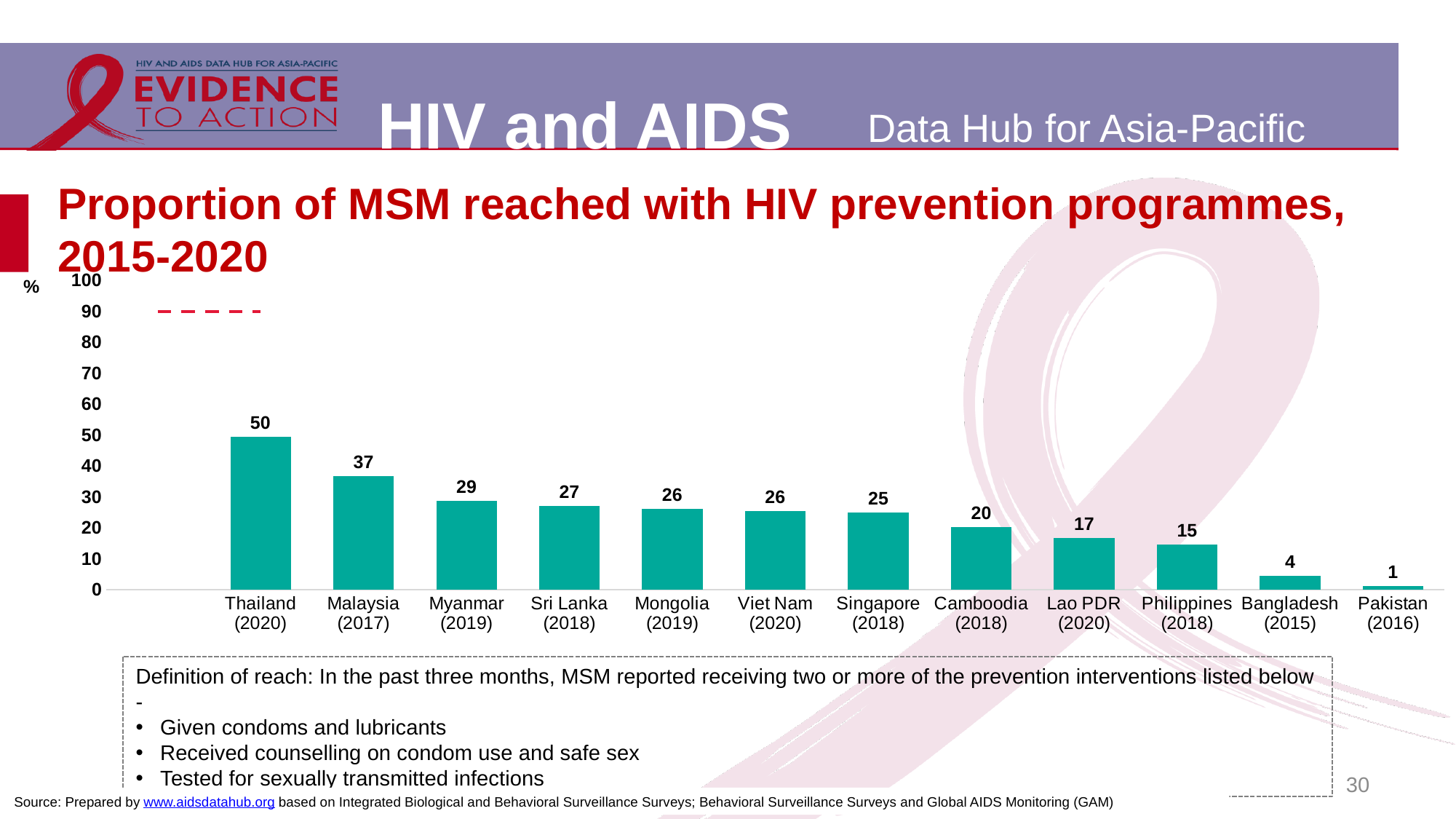
What is the title of the chart? Proportion of MSM reached with HIV prevention programmes, 2015-2020 What is the value for Cambodia (2018)? 20 Which country has the highest proportion of MSM reached? Thailand (2020) Do the values rise or fall from left to right across the chart? fall What is the value for Thailand (2020)? 50 What kind of chart is shown on the slide? bar chart What is the value for Bangladesh (2015)? 4 Which is larger, the value for Myanmar (2019) or the value for Lao PDR (2020)? Myanmar (2019) How many countries are shown on the chart? 12 Which country has the lowest proportion of MSM reached? Pakistan (2016) What is the difference between the values for Thailand (2020) and Malaysia (2017)? 13 Is the value for Philippines (2018) greater or less than 20? less